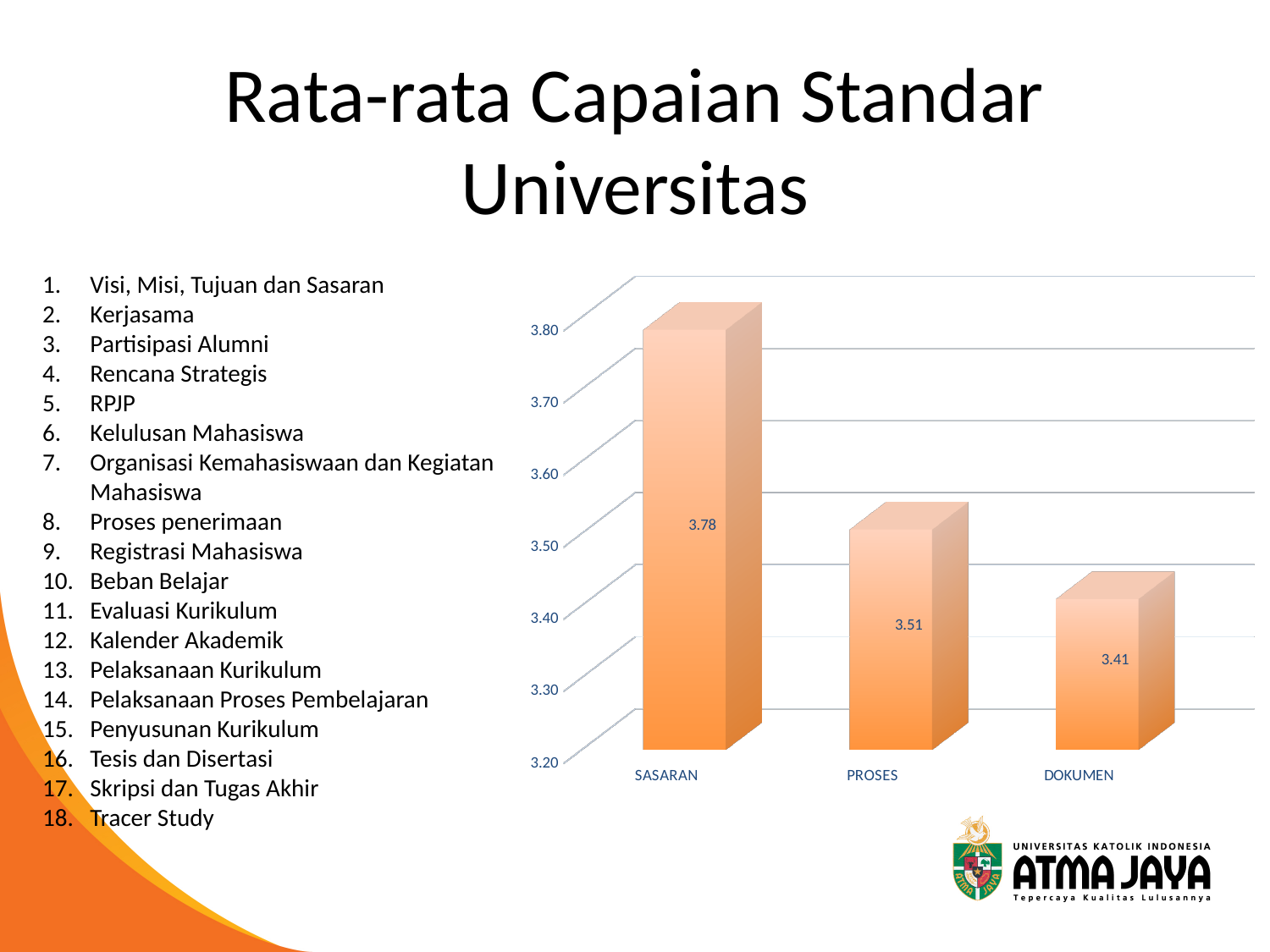
What is the difference between the values for SASARAN and PROSES? 0.27 What is the value for SASARAN? 3.78 Which category has the highest value? SASARAN Do the values rise or fall from SASARAN to DOKUMEN along the x axis? fall Which category has the lowest value? DOKUMEN Which is larger, the value for PROSES or the value for DOKUMEN? PROSES What is the difference between the values for PROSES and DOKUMEN? 0.10 What kind of chart is shown on the slide? bar chart Is the value for SASARAN greater or less than 3.70? greater What is the value for DOKUMEN? 3.41 How many categories are shown on the x axis of the chart? 3 What is the value for PROSES? 3.51